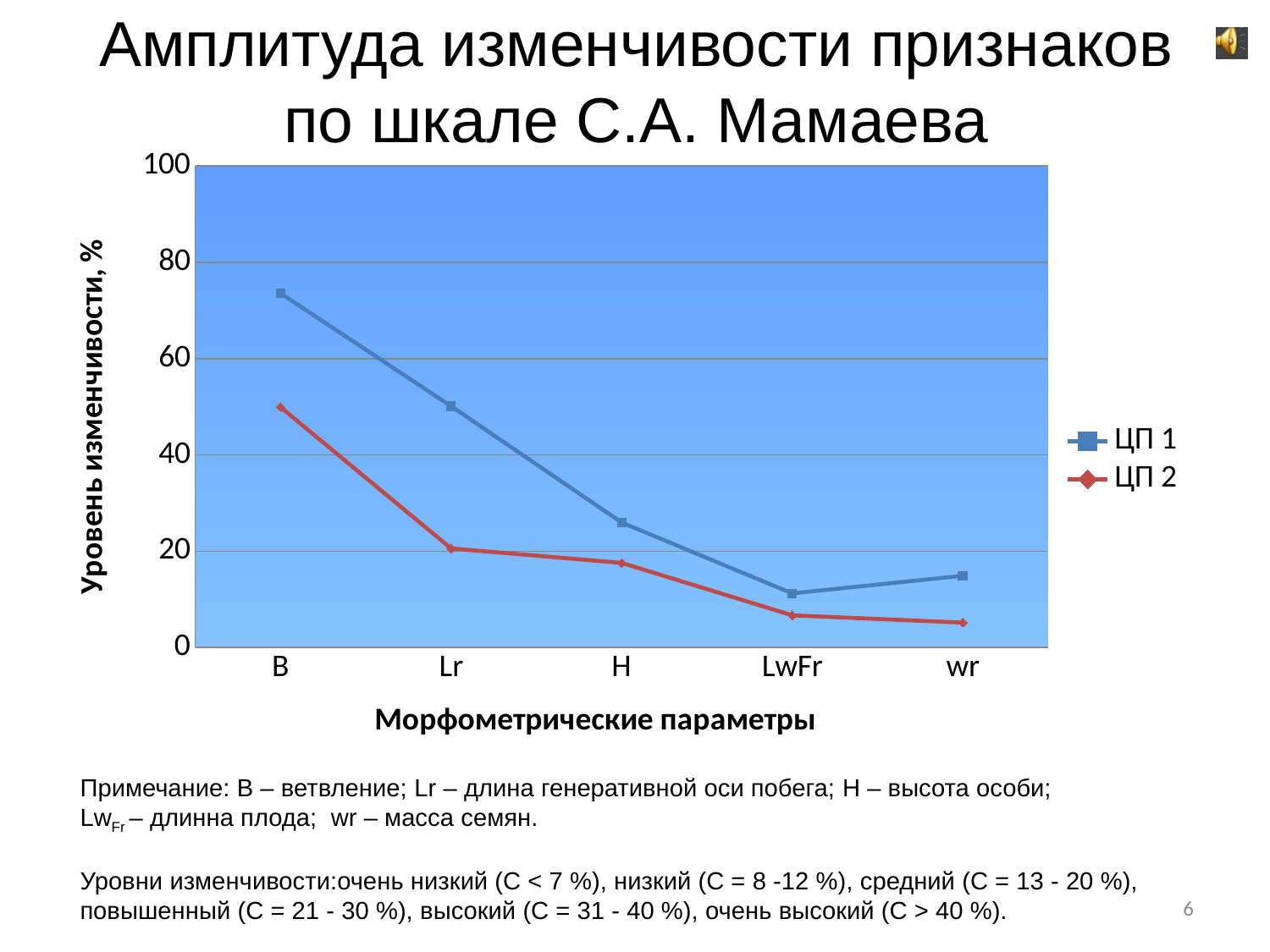
How many categories are shown on the x axis? 5 Is the value of ЦП 1 for LwFr greater or less than 20? less Is the value of ЦП 2 for wr greater or less than 20? less Which series has the larger value for B, ЦП 1 or ЦП 2? ЦП 1 How many series does the legend list? 2 What kind of chart is shown on the slide? line chart What is the title of the y axis? Уровень изменчивости, % Do the values of the ЦП 2 series rise or fall from B to wr along the x axis? fall Is the value of ЦП 1 for B greater or less than 60? greater For which category does the ЦП 1 series reach its highest value? B For which category does the ЦП 1 series reach its lowest value? LwFr